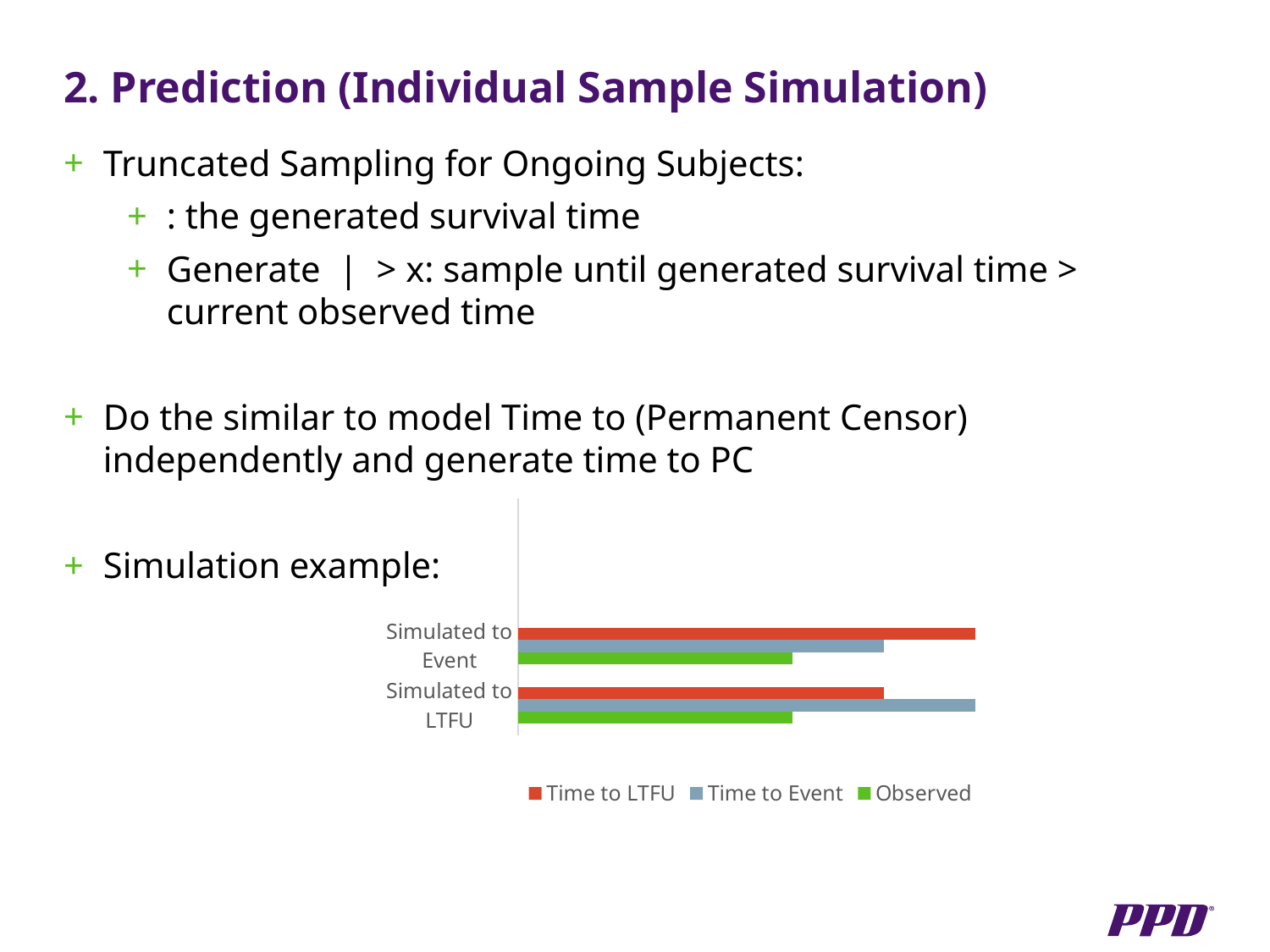
For the Simulated to LTFU category, which series has the longest bar? Time to Event For the Simulated to Event category, which series has the longest bar? Time to LTFU Which colour represents the Observed series in the chart? Green For the Simulated to Event category, which series has the shortest bar? Observed How many series does the chart's legend list? 3 For the Simulated to LTFU category, which is larger: Time to LTFU or Time to Event? Time to Event What kind of chart is shown on the slide? Bar chart For the Simulated to LTFU category, which series has the shortest bar? Observed How many categories are shown on the chart's vertical axis? 2 For the Simulated to Event category, which is larger: Time to LTFU or Time to Event? Time to LTFU In which category is the Time to Event bar longer: Simulated to Event or Simulated to LTFU? Simulated to LTFU What are the names of the series listed in the chart's legend? Time to LTFU, Time to Event, Observed